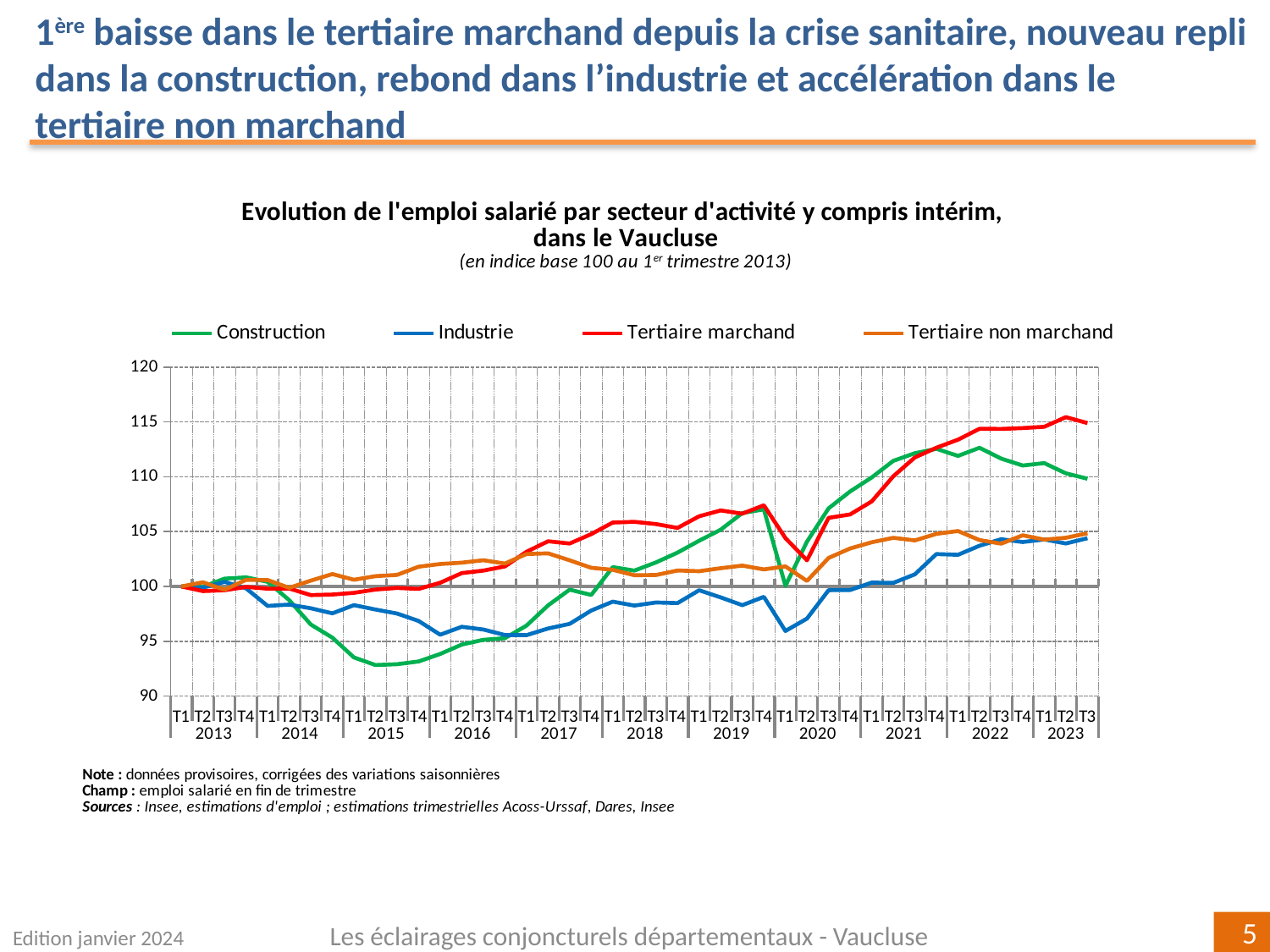
Is the value for Industrie at T1 2020 greater or less than 100? less What colour is the Industrie line? Blue Does the Tertiaire marchand line overall rise or fall from 2013 to 2023? Rise At T3 2023, which is higher: Tertiaire marchand or Construction? Tertiaire marchand Is the value for Tertiaire marchand at T3 2023 greater or less than 110? greater Which series are listed in the legend? Construction, Industrie, Tertiaire marchand, Tertiaire non marchand Which series reaches the highest value on the chart? Tertiaire marchand Is the value for Tertiaire non marchand at T3 2023 greater or less than 100? greater Which series reaches the lowest value on the chart? Construction What kind of chart is shown on the slide? Line chart How many series does the legend list? 4